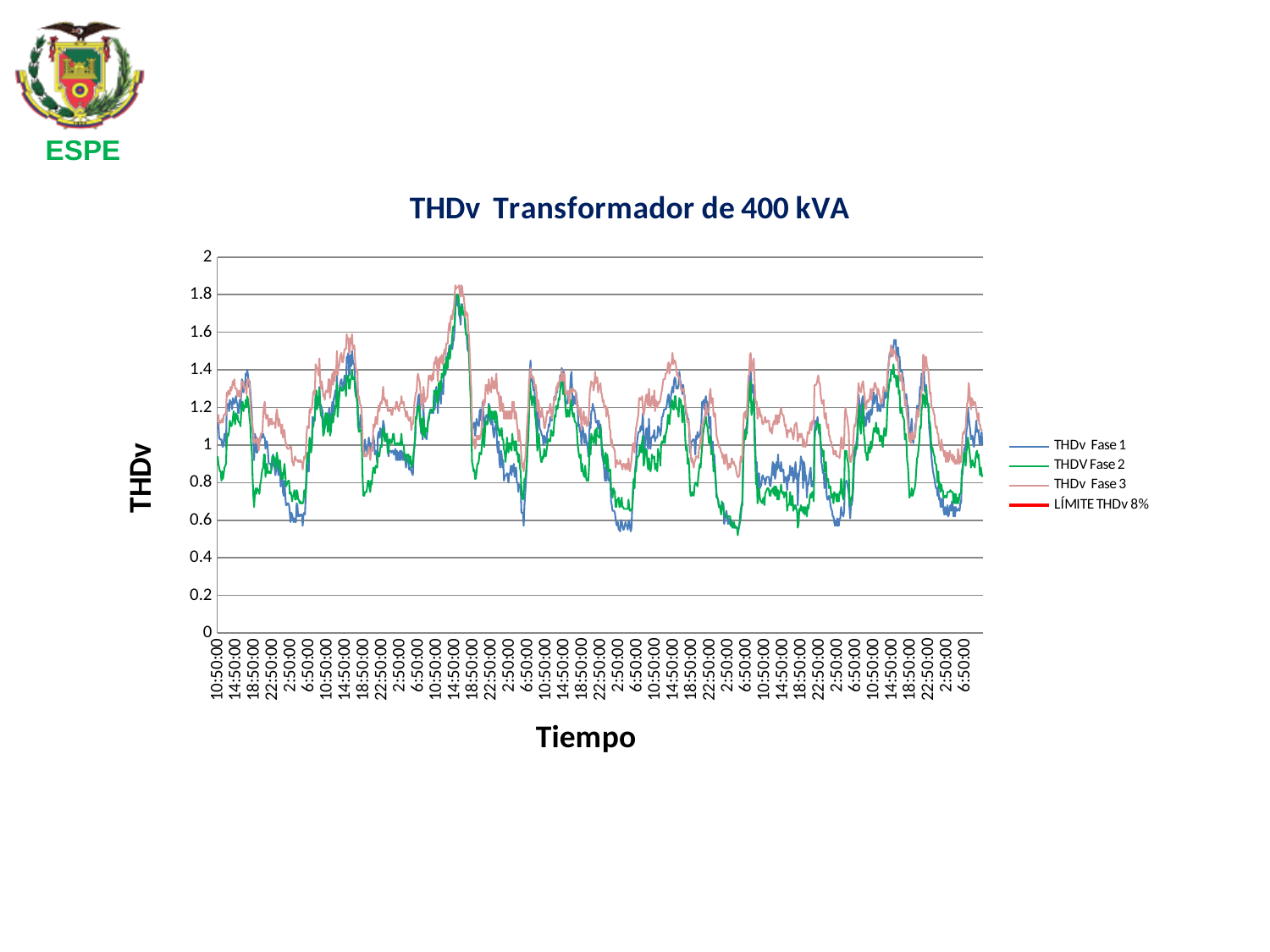
What is the first time label on the horizontal axis? 10:50:00 Is the highest peak of THDv Fase 3 greater or less than 1.6? greater What is the title of the chart? THDv Transformador de 400 kVA What kind of chart is shown on the slide? line chart How many entries does the chart legend list? 4 Which phase series generally lies highest across the chart? THDv Fase 3 Is the highest value reached by any of the phase series greater or less than 2? less What is the highest value shown on the vertical (THDv) axis? 2 Is the lowest value of THDv Fase 3 greater or less than 0.6? greater What is the name of the red series in the legend? LÍMITE THDv 8%